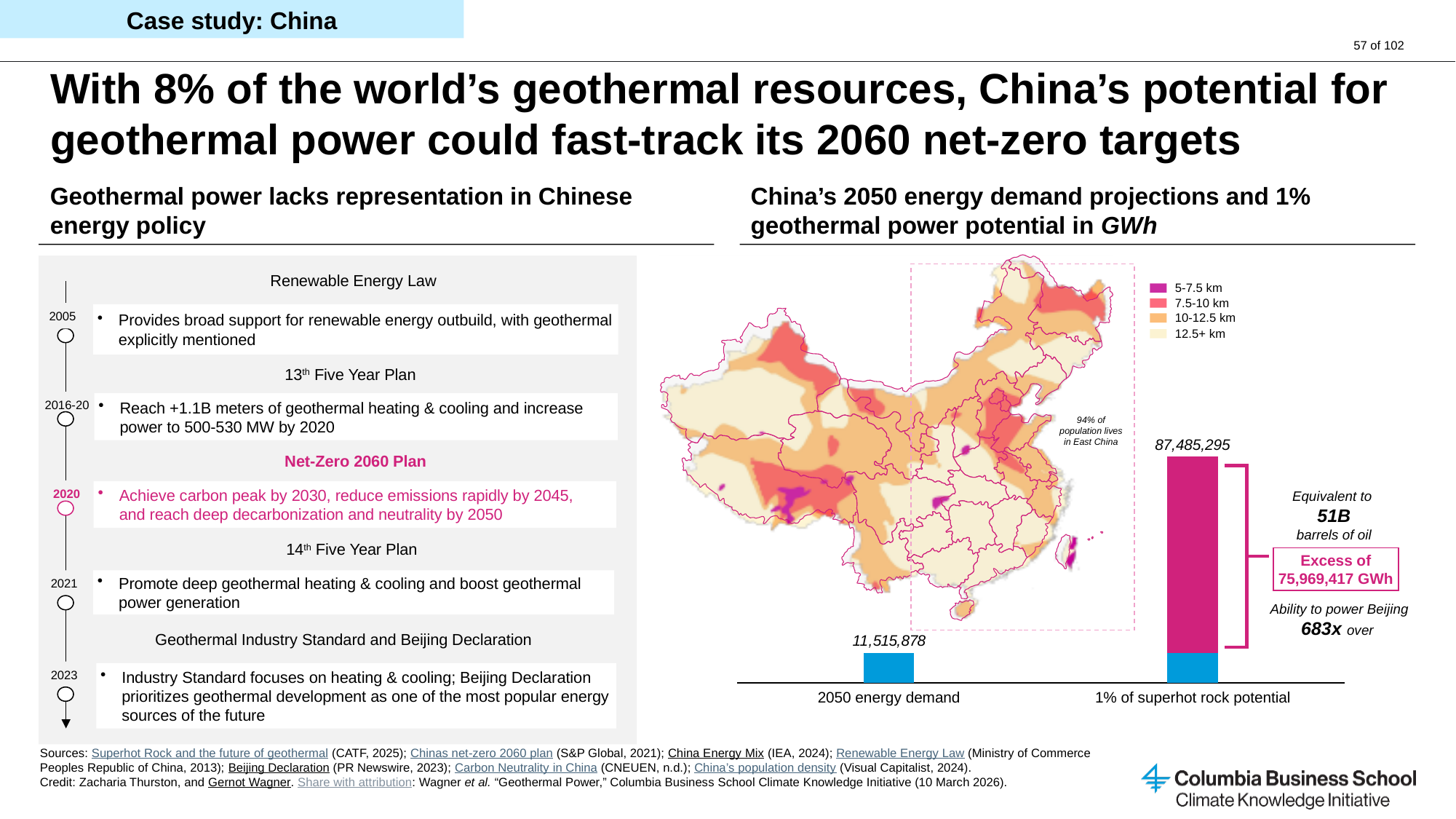
In the bar chart on the right, what is the excess of 1% of superhot rock potential over 2050 energy demand, as labelled on the slide? Excess of 75,969,417 GWh In the chart 'China's 2050 energy demand projections and 1% geothermal power potential in GWh', what is the value for 1% of superhot rock potential? 87,485,295 In the bar chart on the right, what is the difference between 1% of superhot rock potential and 2050 energy demand? 75,969,417 In the bar chart on the right, which category has the higher value? 1% of superhot rock potential How many categories are shown on the x axis of the bar chart on the right? 2 According to the annotation next to the bar chart on the right, how many barrels of oil is the excess equivalent to? 51B In the chart 'China's 2050 energy demand projections and 1% geothermal power potential in GWh', what is the value for 2050 energy demand? 11,515,878 In the bar chart on the right, which category has the lower value? 2050 energy demand What kind of chart is shown on the right side of the slide under the map? bar chart How many depth ranges does the legend of the map on the right list? 4 In the bar chart on the right, is the value for 2050 energy demand larger or smaller than the value for 1% of superhot rock potential? smaller In the bar chart on the right, what unit are the values expressed in? GWh